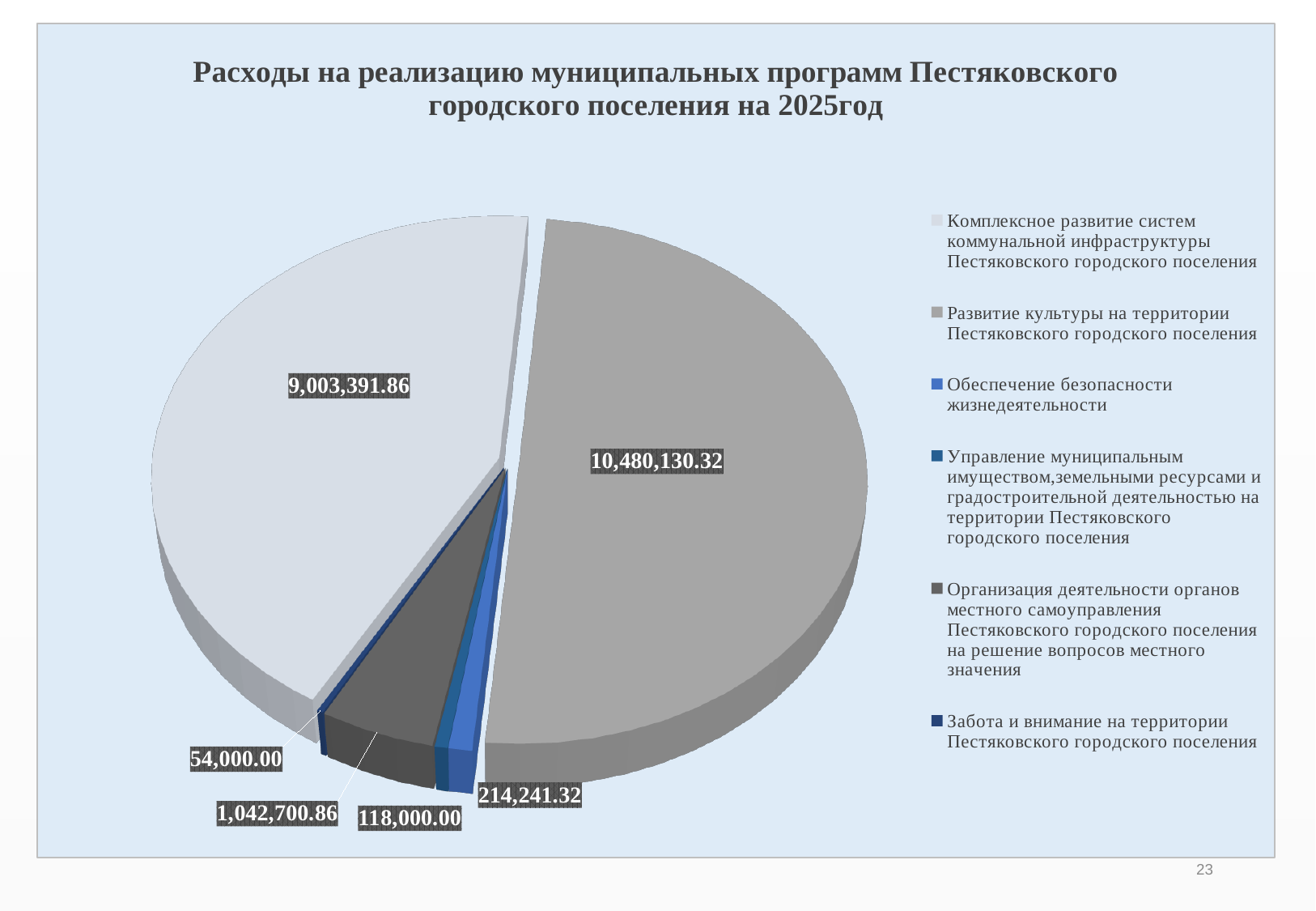
What is the value for «Развитие культуры на территории Пестяковского городского поселения»? 10,480,130.32 Which program has the largest expenditure? Развитие культуры на территории Пестяковского городского поселения Which is larger: the value for «Обеспечение безопасности жизнедеятельности» or for «Управление муниципальным имуществом, земельными ресурсами и градостроительной деятельностью»? Обеспечение безопасности жизнедеятельности What is the value for «Комплексное развитие систем коммунальной инфраструктуры Пестяковского городского поселения»? 9,003,391.86 What is the value for «Обеспечение безопасности жизнедеятельности»? 214,241.32 What is the title of the chart? Расходы на реализацию муниципальных программ Пестяковского городского поселения на 2025год What is the difference between the values for «Развитие культуры» and «Комплексное развитие систем коммунальной инфраструктуры»? 1,476,738.46 Which program has the smallest expenditure? Забота и внимание на территории Пестяковского городского поселения What type of chart is shown on the slide? Pie chart What is the value for «Организация деятельности органов местного самоуправления Пестяковского городского поселения на решение вопросов местного значения»? 1,042,700.86 How many slices does the pie chart have? 6 What is the value for «Забота и внимание на территории Пестяковского городского поселения»? 54,000.00